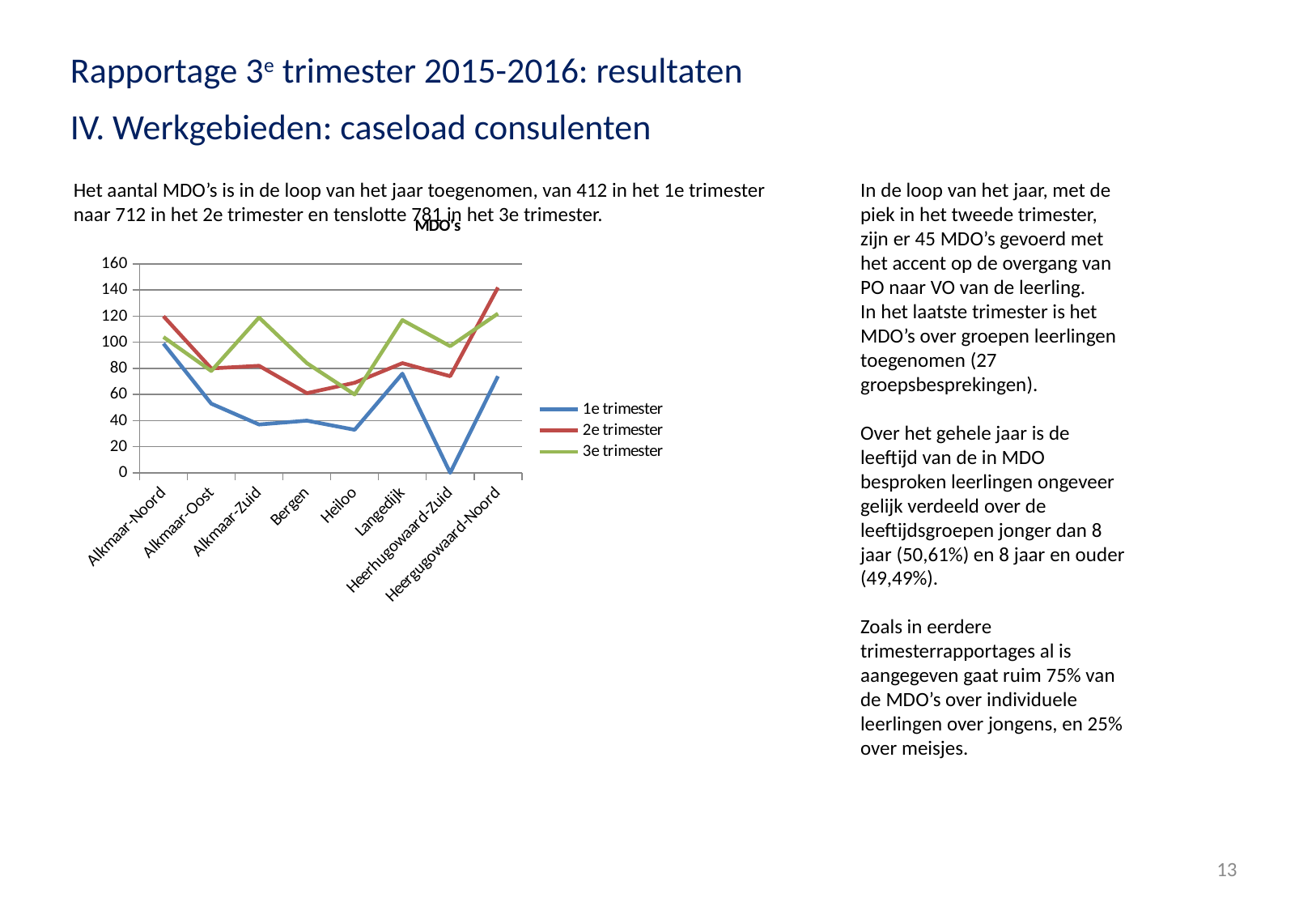
How many series does the legend of the "MDO's" chart list? 3 Does the 1e trimester line rise or fall from Alkmaar-Noord to Heiloo? fall Is the 2e trimester value for Bergen greater or less than 80? less For the 1e trimester series, which category has the lowest value? Heerhugowaard-Zuid For the 2e trimester series, which category has the highest value? Heergugowaard-Noord Which series are listed in the legend of the "MDO's" chart? 1e trimester, 2e trimester, 3e trimester What kind of chart is the "MDO's" chart? line chart Is the 1e trimester value for Heiloo greater or less than 40? less Is the 3e trimester value for Alkmaar-Zuid greater or less than 100? greater At Alkmaar-Zuid, which is larger: the 1e trimester value or the 3e trimester value? 3e trimester How many categories are shown on the x axis of the "MDO's" chart? 8